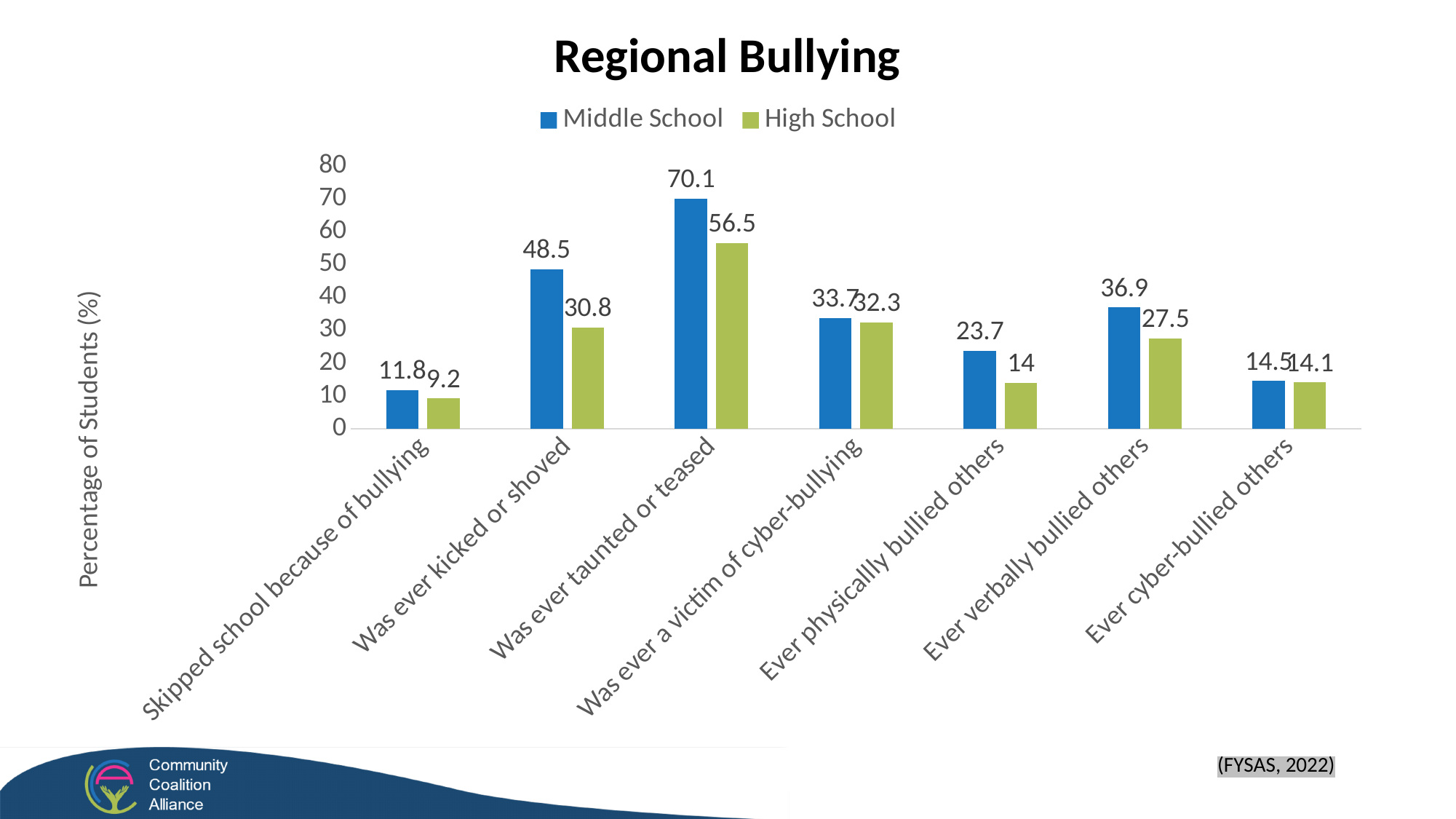
Which category has the lowest High School value? Skipped school because of bullying What is the difference between the Middle School and High School values for 'Was ever kicked or shoved'? 17.7 Is the High School value for 'Was ever taunted or teased' greater or less than 50? greater Which is larger for 'Ever verbally bullied others': the Middle School value or the High School value? Middle School How many series does the legend list? 2 What is the difference between the Middle School and High School values for 'Ever physicallly bullied others'? 9.7 What is the Middle School value for 'Was ever taunted or teased'? 70.1 Which category has the highest Middle School value? Was ever taunted or teased How many categories are shown on the x axis? 7 What is the High School value for 'Ever physicallly bullied others'? 14 What kind of chart is shown on the slide? Bar chart What is the High School value for 'Was ever kicked or shoved'? 30.8